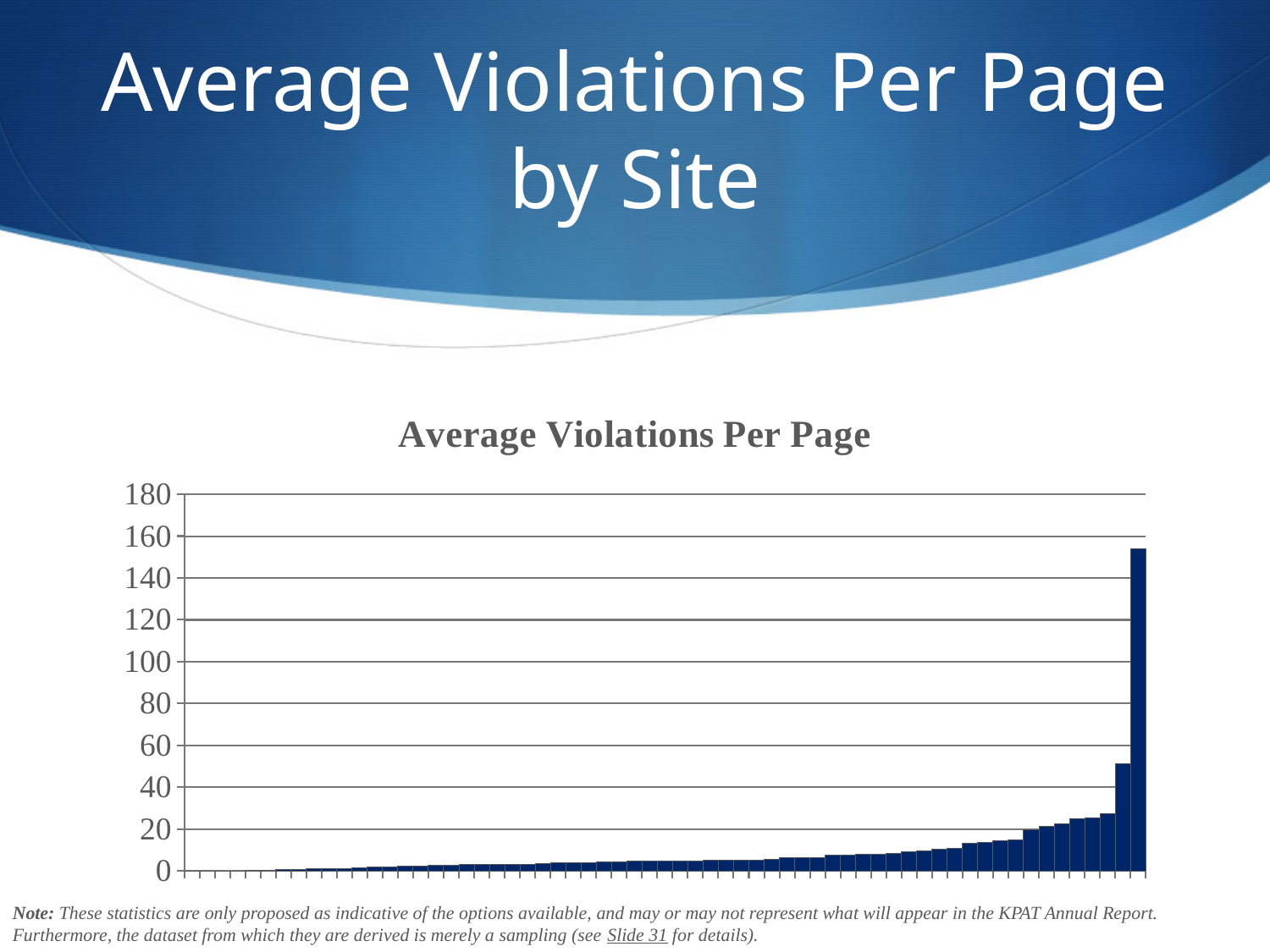
Is the value of the second-tallest bar greater or less than 60? less What is the highest value shown on the vertical axis? 180 What kind of chart is shown on the slide? bar chart Which bar is the highest: the leftmost bar or the rightmost bar? the rightmost bar Is the value of the second-tallest bar greater or less than 40? greater What is the title of the chart? Average Violations Per Page Do the bar values rise or fall from left to right along the x axis? rise Is the value of the tallest bar (rightmost) greater or less than 160? less